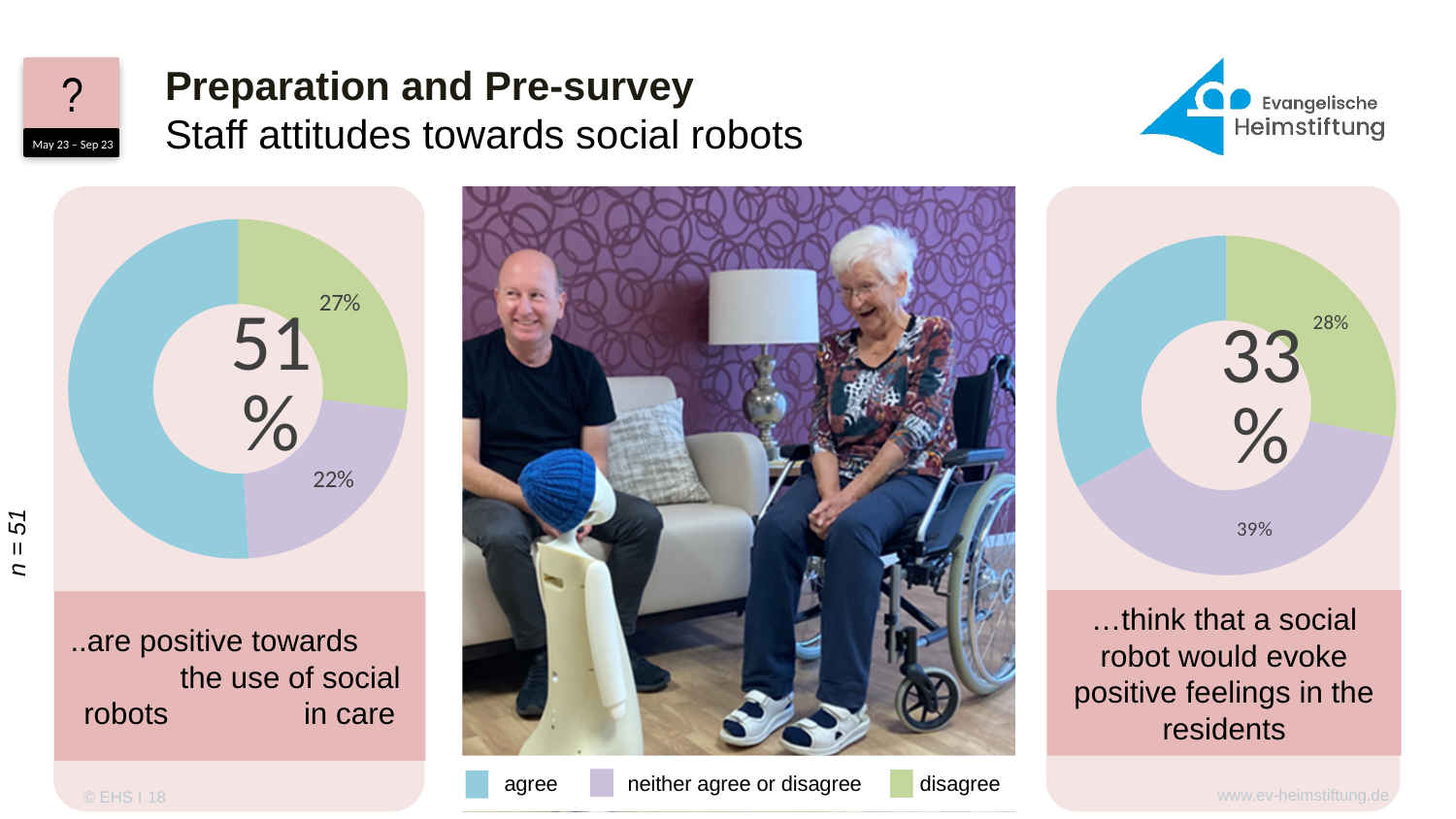
In the left donut chart, what percentage of staff disagree? 27% How many response categories does the legend at the bottom of the slide list? 3 In the right donut chart, what percentage of staff neither agree nor disagree? 39% In the right donut chart, which response category has the largest share? neither agree or disagree In the left donut chart, what percentage of staff are positive towards the use of social robots in care? 51% In the left donut chart, what is the difference in percentage points between the agree and disagree shares? 24 In the right donut chart, which is larger: the share that agrees or the share that neither agrees nor disagrees? neither agree or disagree In the right donut chart, what percentage of staff disagree? 28% In the left donut chart, which response category has the largest share? agree In the left donut chart, what percentage of staff neither agree nor disagree? 22% What type of chart is used on the left and right of the slide? donut (pie) chart In the right donut chart, what percentage of staff think a social robot would evoke positive feelings in the residents? 33%